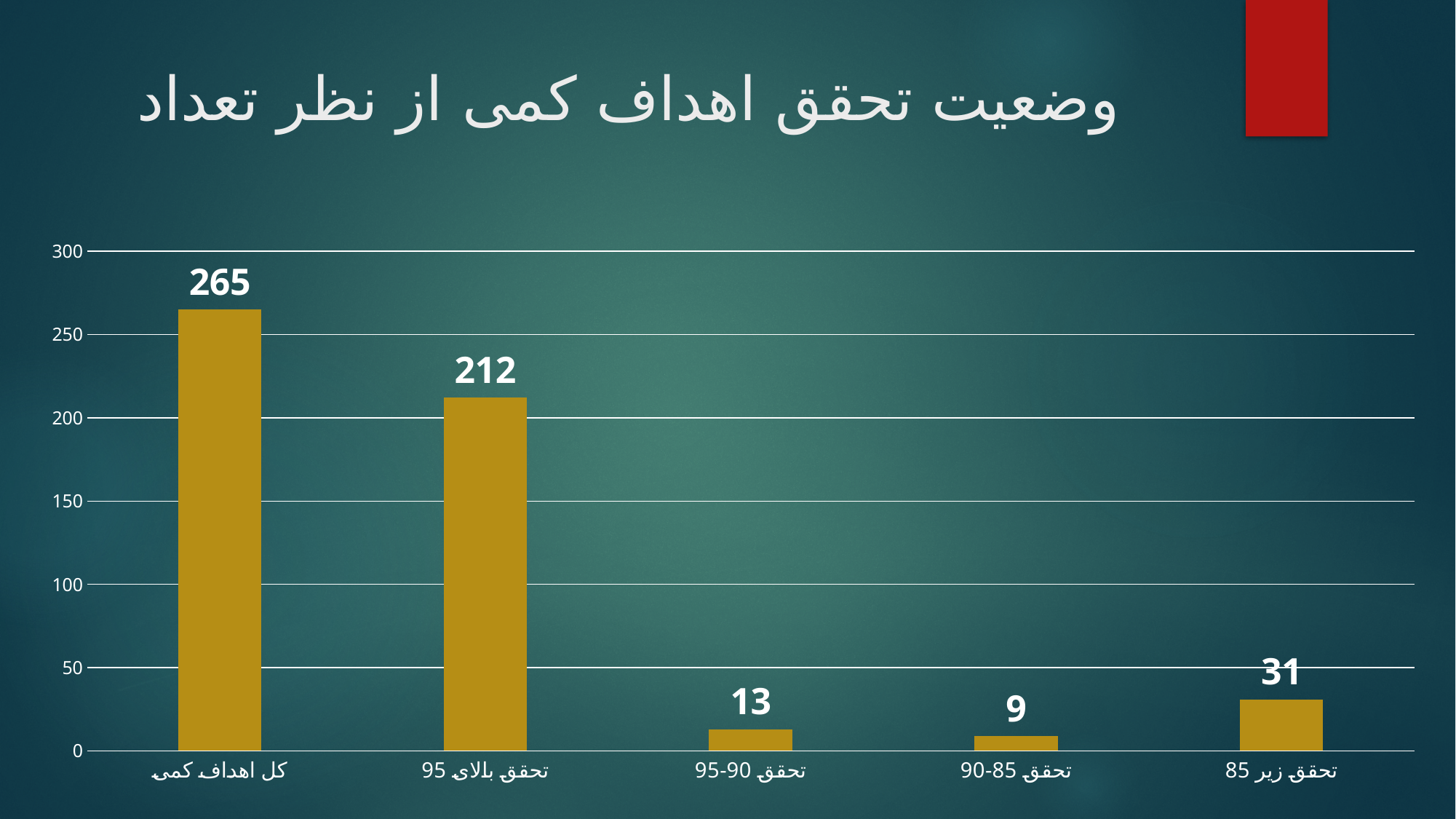
What is the value for تحقق زیر 85? 31 How many categories are shown on the x axis? 5 Which category has the lowest value? تحقق 85-90 What is the value for کل اهداف کمی? 265 What kind of chart is shown on the slide? bar chart What is the value for تحقق 85-90? 9 Is the value for تحقق بالای 95 greater or less than 200? greater What is the difference between the values for کل اهداف کمی and تحقق بالای 95? 53 Which is larger, the value for تحقق 90-95 or the value for تحقق زیر 85? تحقق زیر 85 What is the title of the slide? وضعیت تحقق اهداف کمی از نظر تعداد What is the value for تحقق بالای 95? 212 Which category has the highest value? کل اهداف کمی